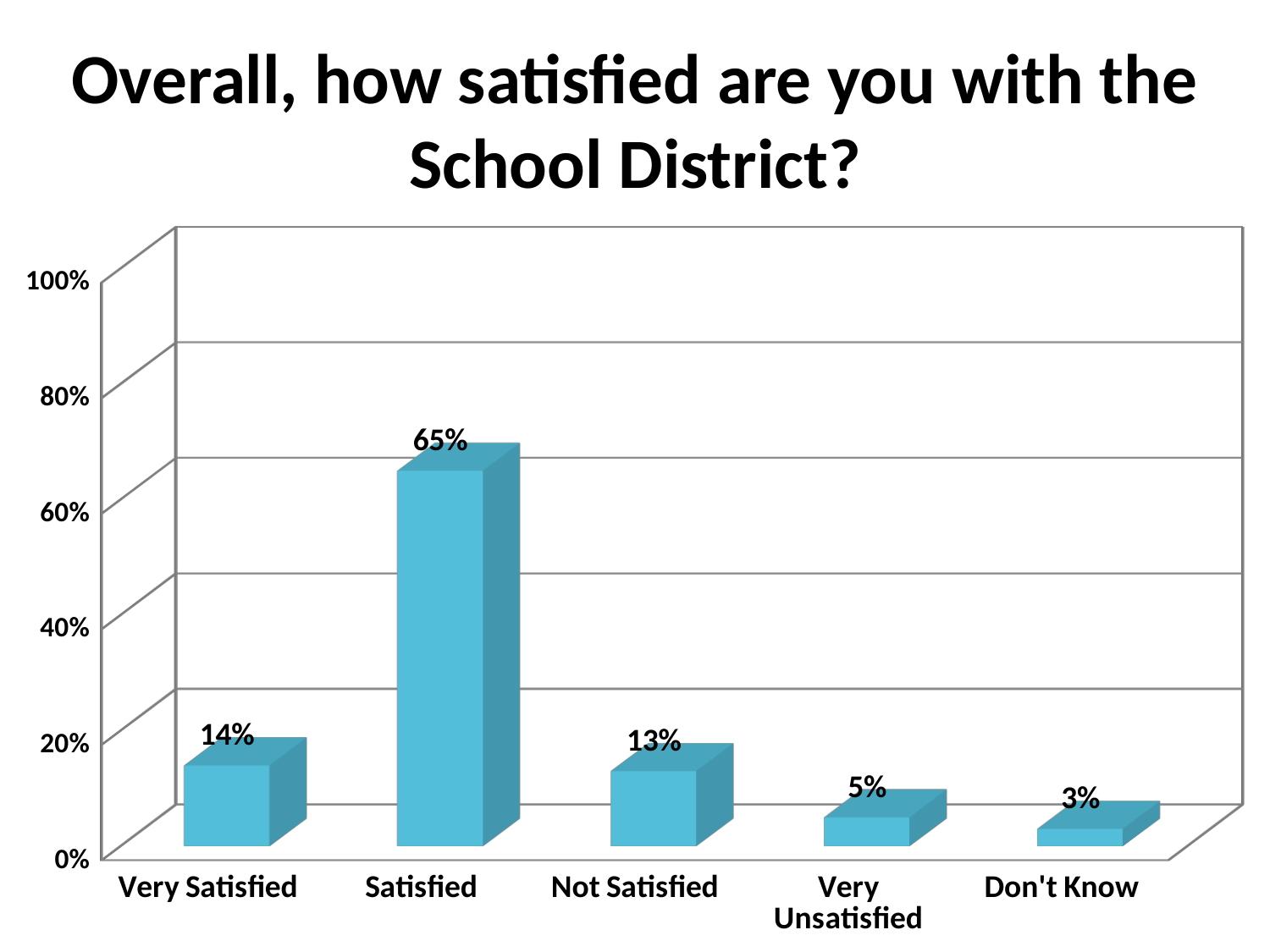
How many categories are shown on the x axis? 5 Which category has the lowest value? Don't Know What is the title of the chart? Overall, how satisfied are you with the School District? What percentage of respondents answered Satisfied? 65% What kind of chart is shown on the slide? Bar chart Which is larger, Very Satisfied or Not Satisfied? Very Satisfied Which category has the highest value? Satisfied What is the value for Don't Know? 3% What is the difference between the Satisfied and Very Satisfied values? 51% What is the difference between Not Satisfied and Very Unsatisfied? 8% What is the value for Very Satisfied? 14% Is the value for Satisfied greater or less than 60%? greater